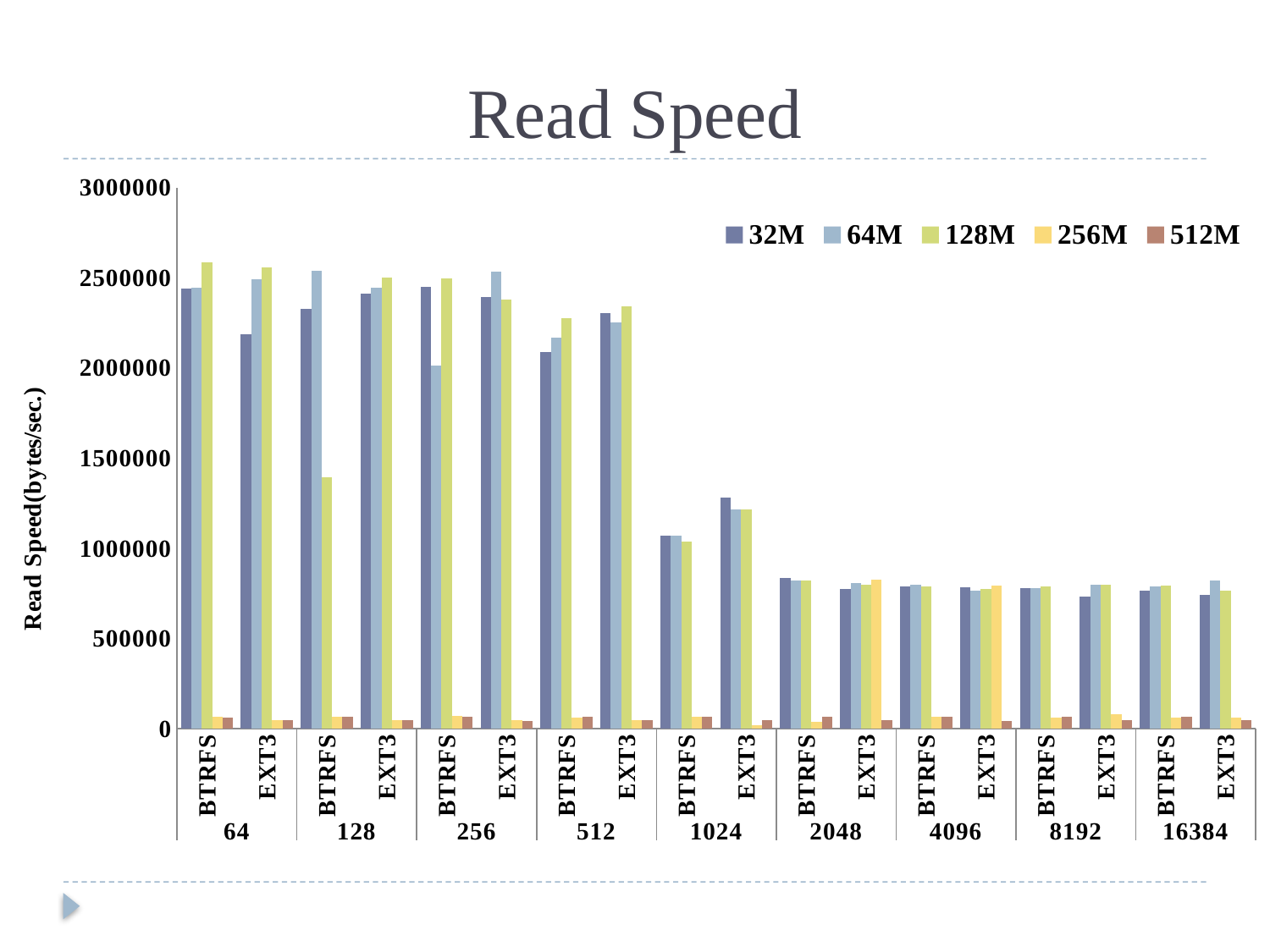
Is the 32M value for BTRFS at size 64 greater or less than 2000000? greater For BTRFS at size 256, which is larger: the 32M value or the 64M value? 32M Is the 32M value for BTRFS at size 2048 greater or less than 1000000? less Is the 32M value for EXT3 at size 1024 greater or less than 1000000? greater What is the label on the vertical axis? Read Speed(bytes/sec.) What is the title of the chart? Read Speed For BTRFS at size 128, which is larger: the 64M value or the 128M value? 64M How many series does the legend list? 5 How many file-system categories (BTRFS/EXT3 pairs across all sizes) are plotted along the x axis? 18 What kind of chart is shown on the slide? bar chart